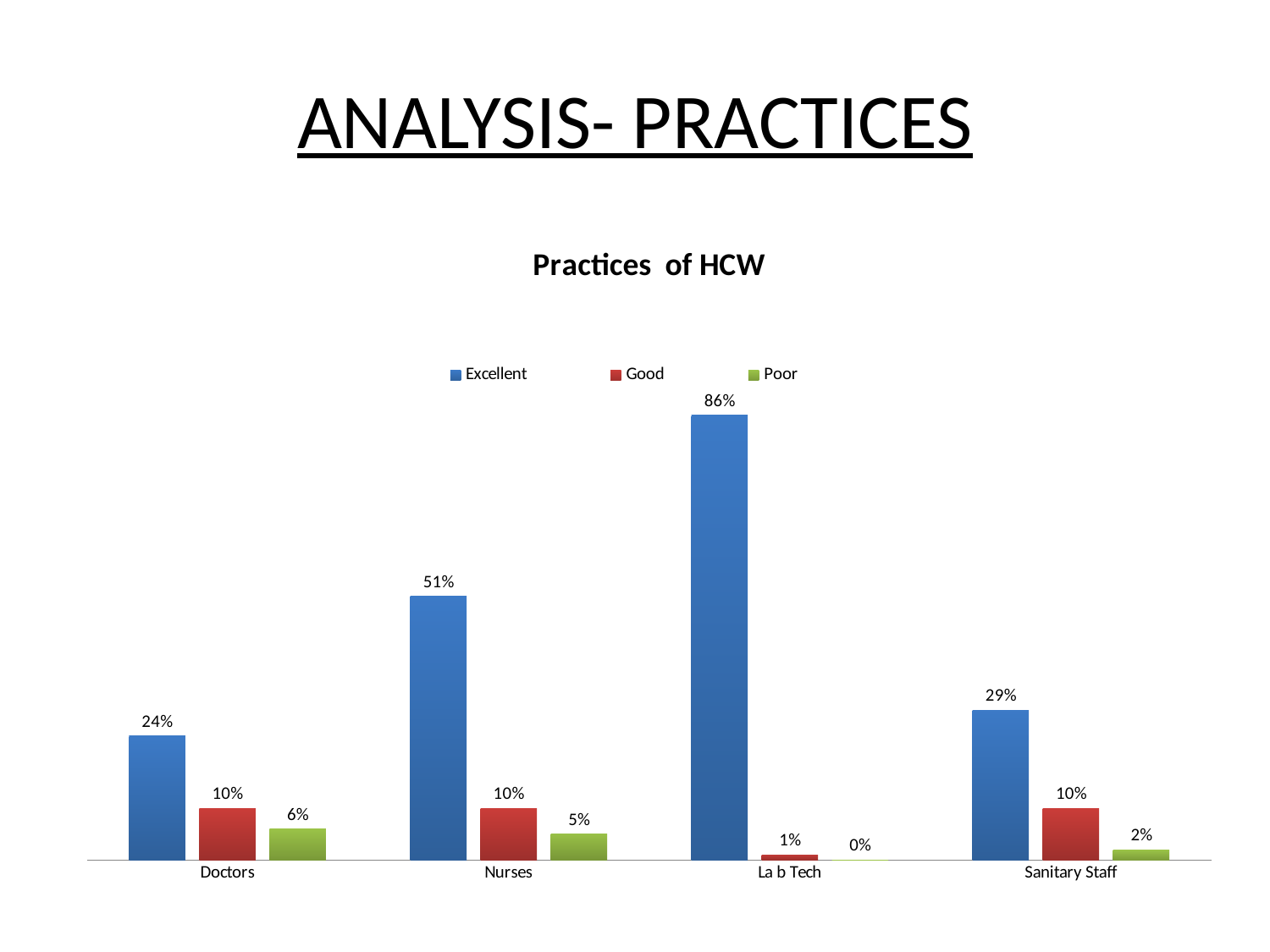
How many series does the legend list? 3 How many categories are shown on the x axis? 4 Which is larger, the Excellent value for Sanitary Staff or the Excellent value for Doctors? Sanitary Staff Which category has the highest Excellent value? La b Tech What kind of chart is shown? bar chart What is the Excellent value for Nurses? 51% What is the Good value for La b Tech? 1% What is the Poor value for Doctors? 6% What is the title of the chart? Practices of HCW Which category has the lowest Poor value? La b Tech What is the difference between the Excellent values for La b Tech and Nurses? 35% Which colour represents the Good series? red